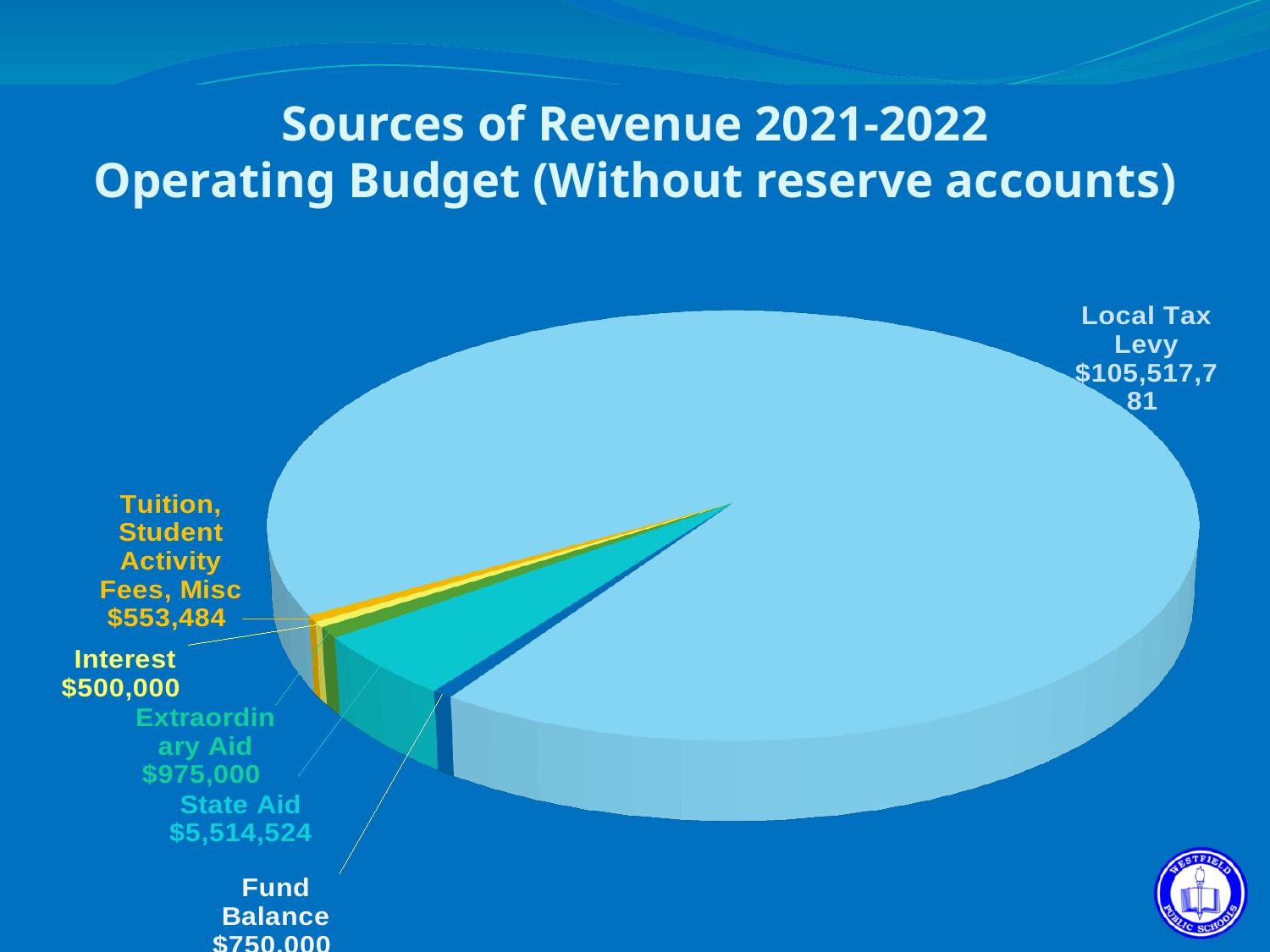
Which is larger, Fund Balance or Interest? Fund Balance What is the difference between State Aid and Extraordinary Aid? $4,539,524 Which revenue source is the largest? Local Tax Levy What is the value for Local Tax Levy? $105,517,781 Which revenue source is the smallest? Interest What is the title of the chart? Sources of Revenue 2021-2022 Operating Budget (Without reserve accounts) What is the value for Fund Balance? $750,000 What type of chart is shown on the slide? Pie chart How many revenue sources are shown in the pie chart? 6 What is the value for Tuition, Student Activity Fees, Misc? $553,484 What is the value for Extraordinary Aid? $975,000 What is the value for State Aid? $5,514,524